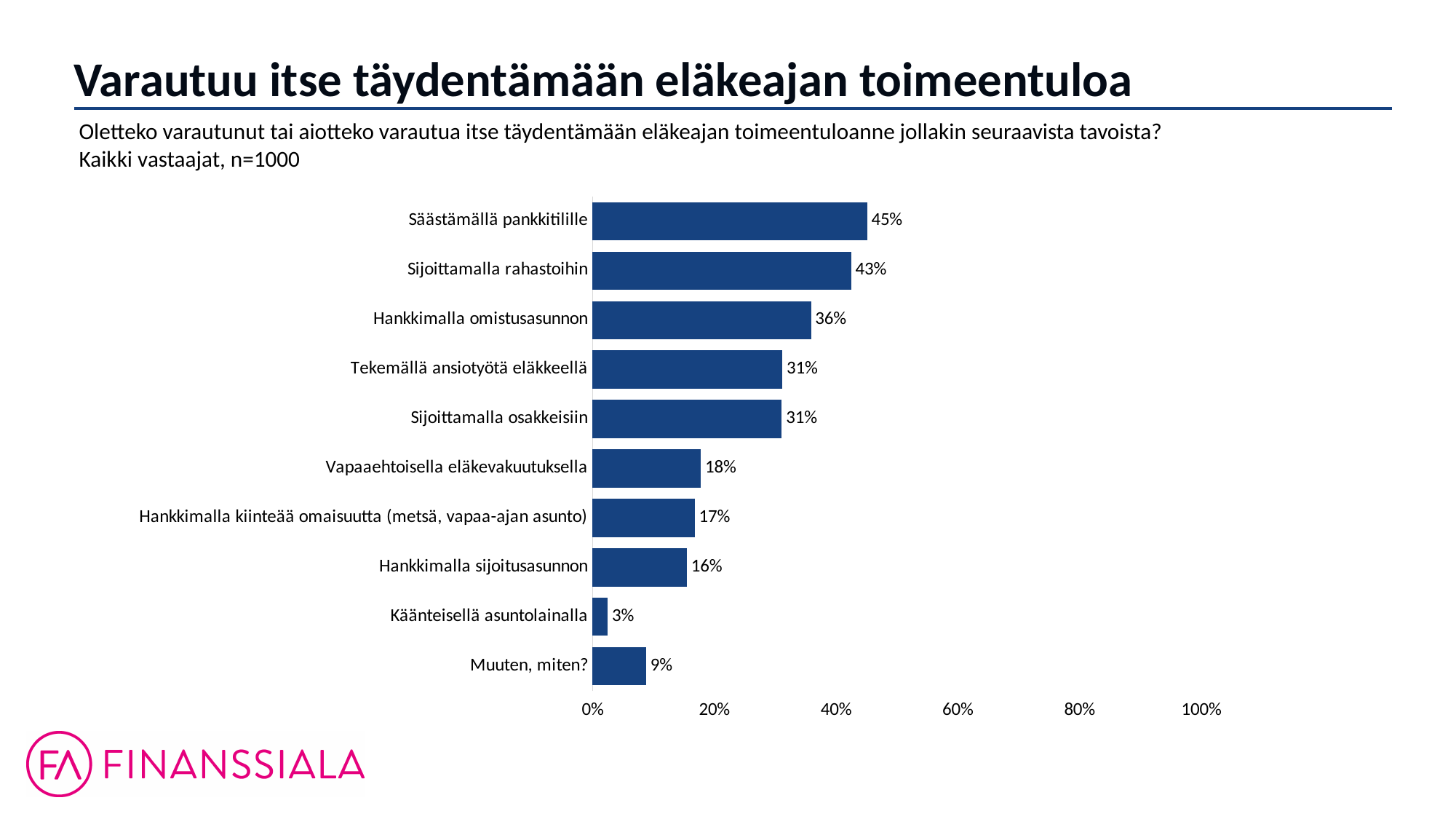
What is the value for Vapaaehtoisella eläkevakuutuksella? 18% What is the difference between Sijoittamalla rahastoihin and Hankkimalla sijoitusasunnon? 27 percentage points Which is larger, Hankkimalla omistusasunnon or Sijoittamalla osakkeisiin? Hankkimalla omistusasunnon What kind of chart is shown on the slide? Bar chart What is the value for Säästämällä pankkitilille? 45% Which category has the lowest value? Käänteisellä asuntolainalla How many categories are shown in the chart? 10 What is the value for Käänteisellä asuntolainalla? 3% Which category has the highest value? Säästämällä pankkitilille What is the value for Hankkimalla omistusasunnon? 36% Is the value for Sijoittamalla rahastoihin greater or less than 40%? greater What is the sample size stated on the slide? n=1000